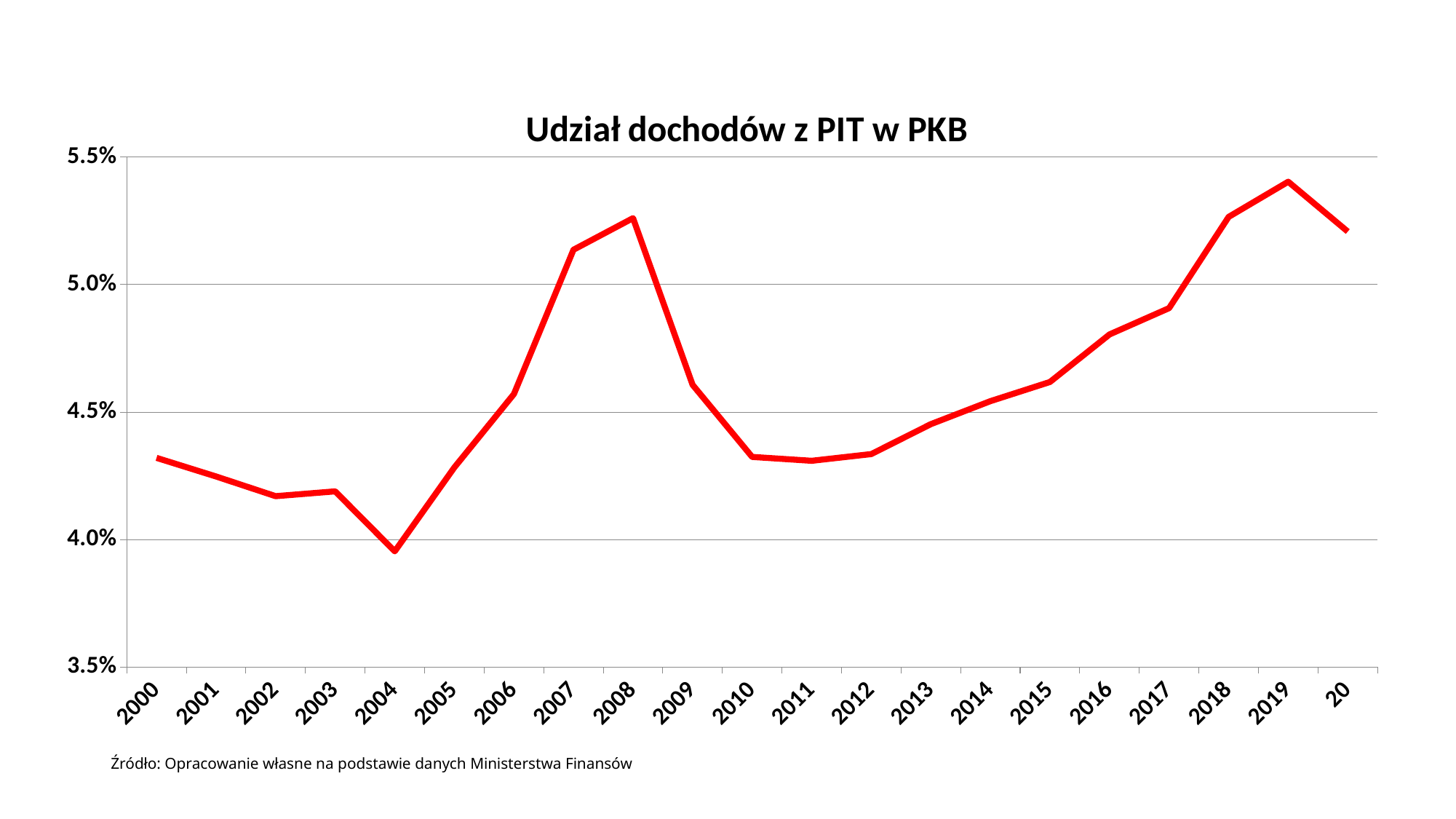
Does the value rise or fall between 2011 and 2019? rise Does the value rise or fall between 2008 and 2010? fall Is the value for 2016 greater or less than 4.5%? greater Which year has a higher value, 2008 or 2019? 2019 In which year is the share of PIT revenue in GDP the highest? 2019 What kind of chart is shown on the slide? line chart Which year has a higher value, 2000 or 2002? 2000 Is the value for 2010 greater or less than 4.5%? less What is the title of the chart? Udział dochodów z PIT w PKB Is the value for 2004 greater or less than 4.0%? less In which year is the share of PIT revenue in GDP the lowest? 2004